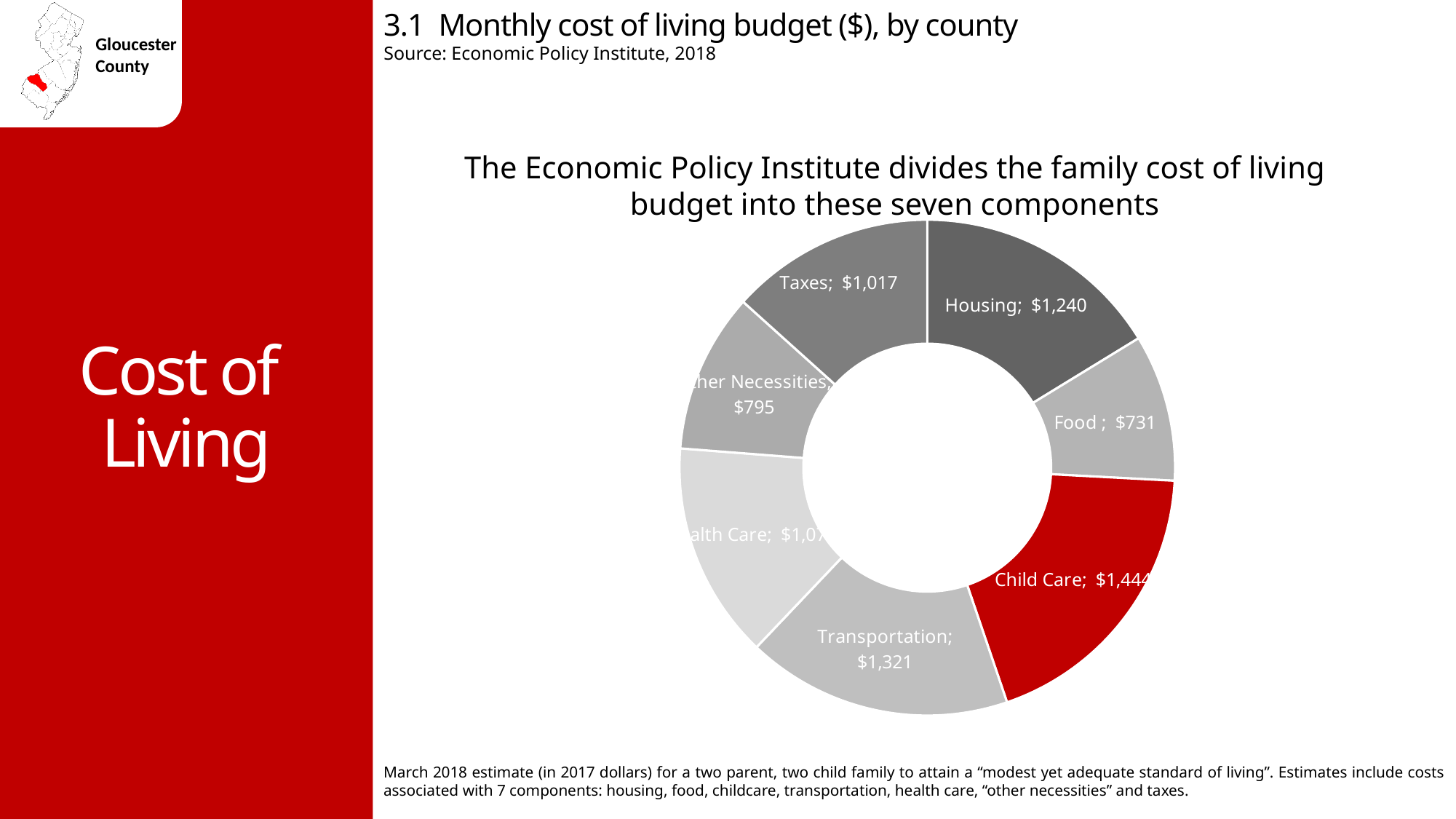
What is the monthly cost for Transportation shown on the chart? $1,321 How many components are shown in the chart? 7 What type of chart is used on the slide? Pie (doughnut) chart Which is larger, the monthly cost for Transportation or for Housing? Transportation What is the monthly cost for Housing shown on the chart? $1,240 Which component has the lowest monthly cost on the chart? Food How much more is the monthly cost of Child Care than Housing? $204 What is the monthly cost for Food shown on the chart? $731 Which component has the highest monthly cost on the chart? Child Care What is the monthly cost for Taxes shown on the chart? $1,017 What is the difference between the Transportation and Taxes monthly costs? $304 What is the monthly cost for Child Care shown on the chart? $1,444